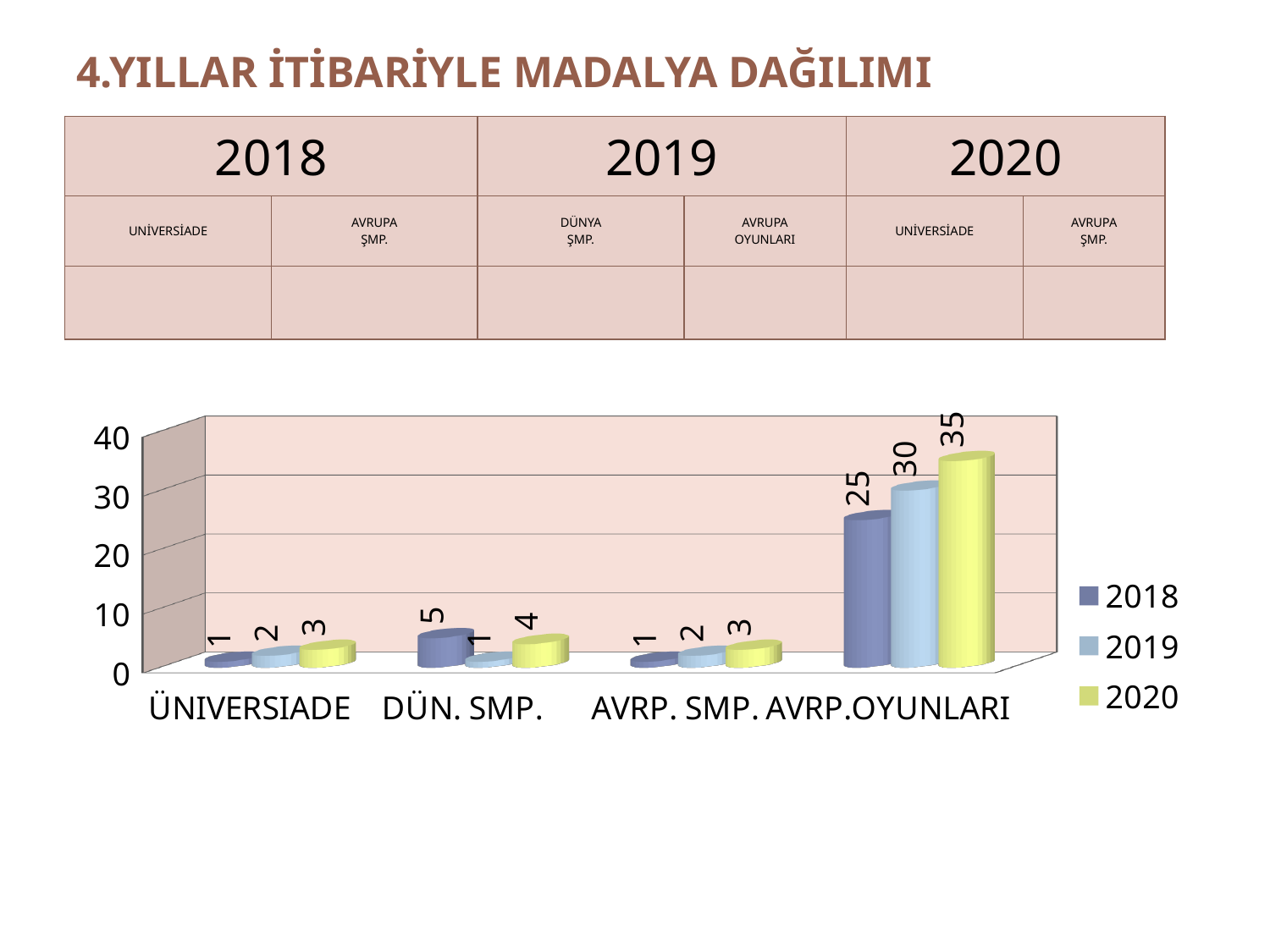
What is the value for DÜN. SMP. in the 2018 series? 5 Which category has the lowest value in the 2018 series? ÜNIVERSIADE and AVRP. SMP. (both 1) What is the value for ÜNIVERSIADE in the 2019 series? 2 Do the values for AVRP.OYUNLARI rise or fall from 2018 to 2020? rise What is the value for AVRP.OYUNLARI in the 2020 series? 35 For DÜN. SMP., which is larger: the 2018 value or the 2020 value? 2018 How many categories are shown on the x axis? 4 What kind of chart is shown on the slide? bar chart What is the difference between the 2020 and 2018 values for AVRP.OYUNLARI? 10 How many series does the legend list? 3 Which category has the highest value in the 2019 series? AVRP.OYUNLARI Is the 2019 value for AVRP.OYUNLARI greater or less than 20? greater